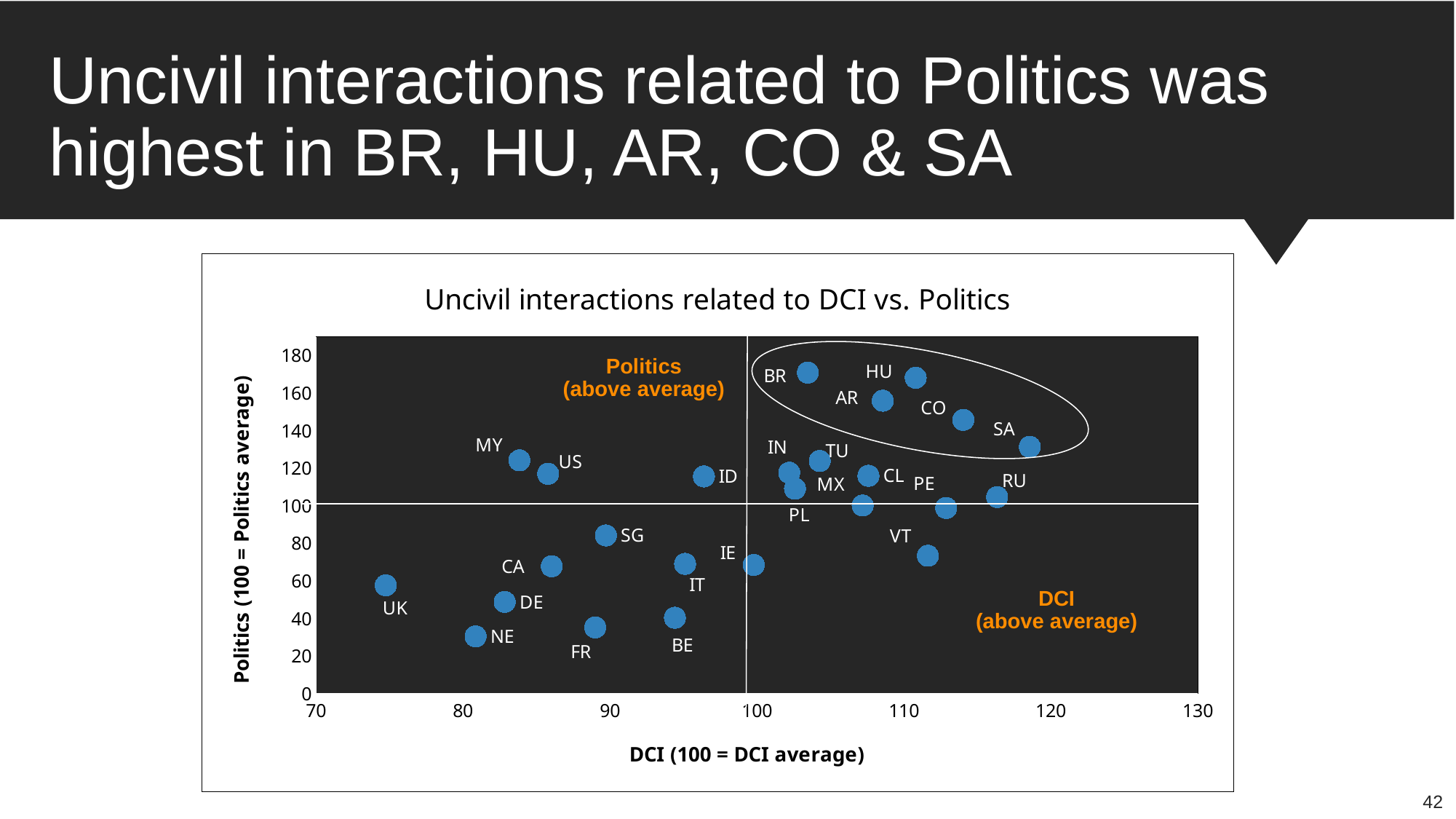
What is the title of the chart? Uncivil interactions related to DCI vs. Politics Is the Politics value for VT greater or less than 80? less Is the DCI value for SA greater or less than 110? greater Which has the higher Politics value, BR or UK? BR Which has the higher DCI value, SA or MY? SA Which country has the lowest DCI value on the chart? UK Is the DCI value for MY greater or less than 90? less What kind of chart is shown on the slide? Scatter chart What is the label of the horizontal axis of the chart? DCI (100 = DCI average) Which country has the highest DCI value on the chart? SA